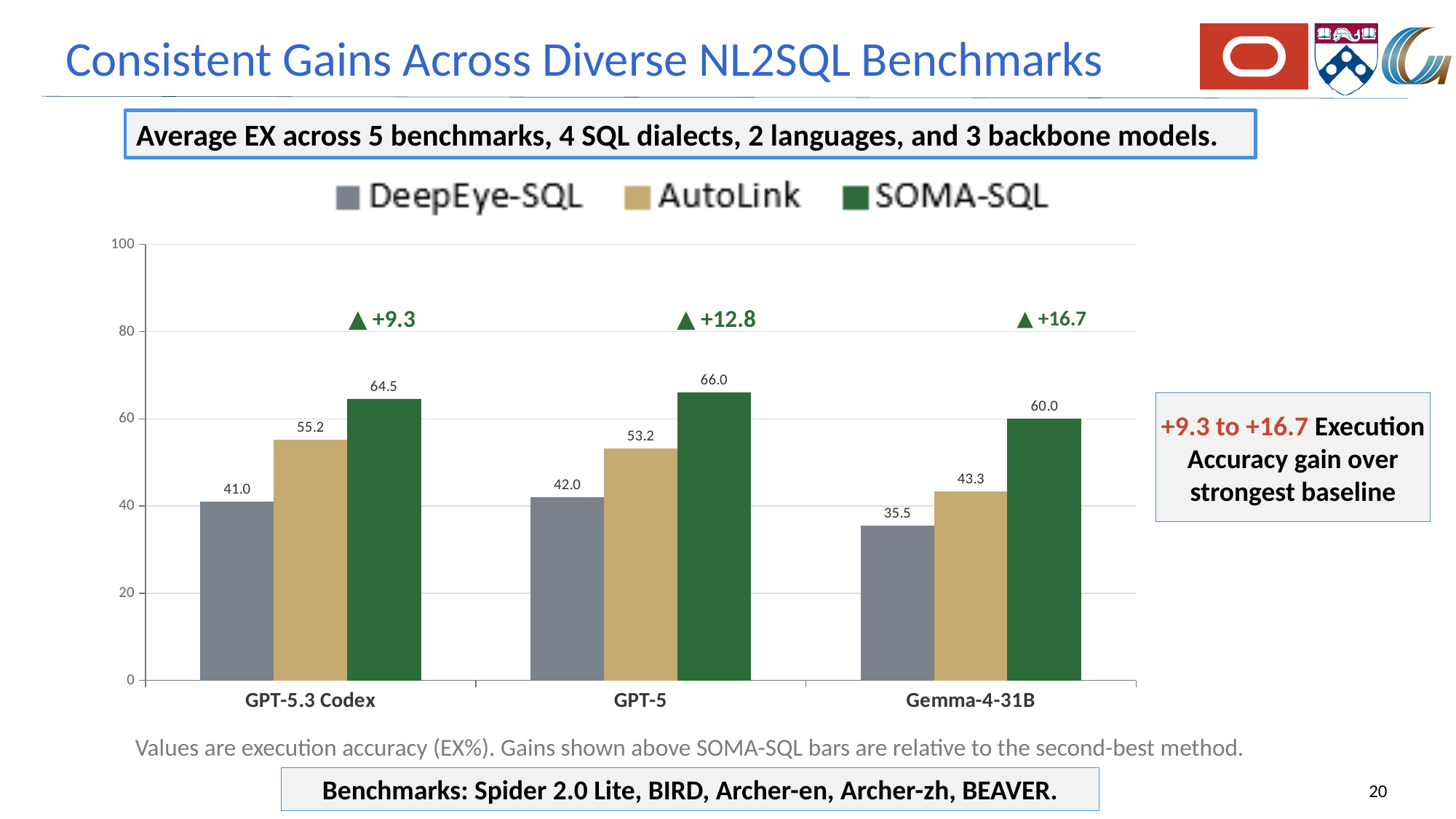
What is the value for DeepEye-SQL on Gemma-4-31B? 35.5 Which is larger on GPT-5.3 Codex: the AutoLink value or the DeepEye-SQL value? AutoLink Which backbone model has the highest SOMA-SQL value? GPT-5 What is the value for SOMA-SQL on GPT-5? 66.0 What gain is shown above the SOMA-SQL bar for GPT-5? +12.8 What kind of chart is shown on the slide? bar chart What is the difference between the SOMA-SQL and AutoLink values on Gemma-4-31B? 16.7 Is the value for SOMA-SQL on GPT-5.3 Codex greater or less than 60? greater How many series does the legend list? 3 What is the value for AutoLink on GPT-5.3 Codex? 55.2 Which backbone model has the lowest DeepEye-SQL value? Gemma-4-31B How many backbone models are shown on the x axis? 3